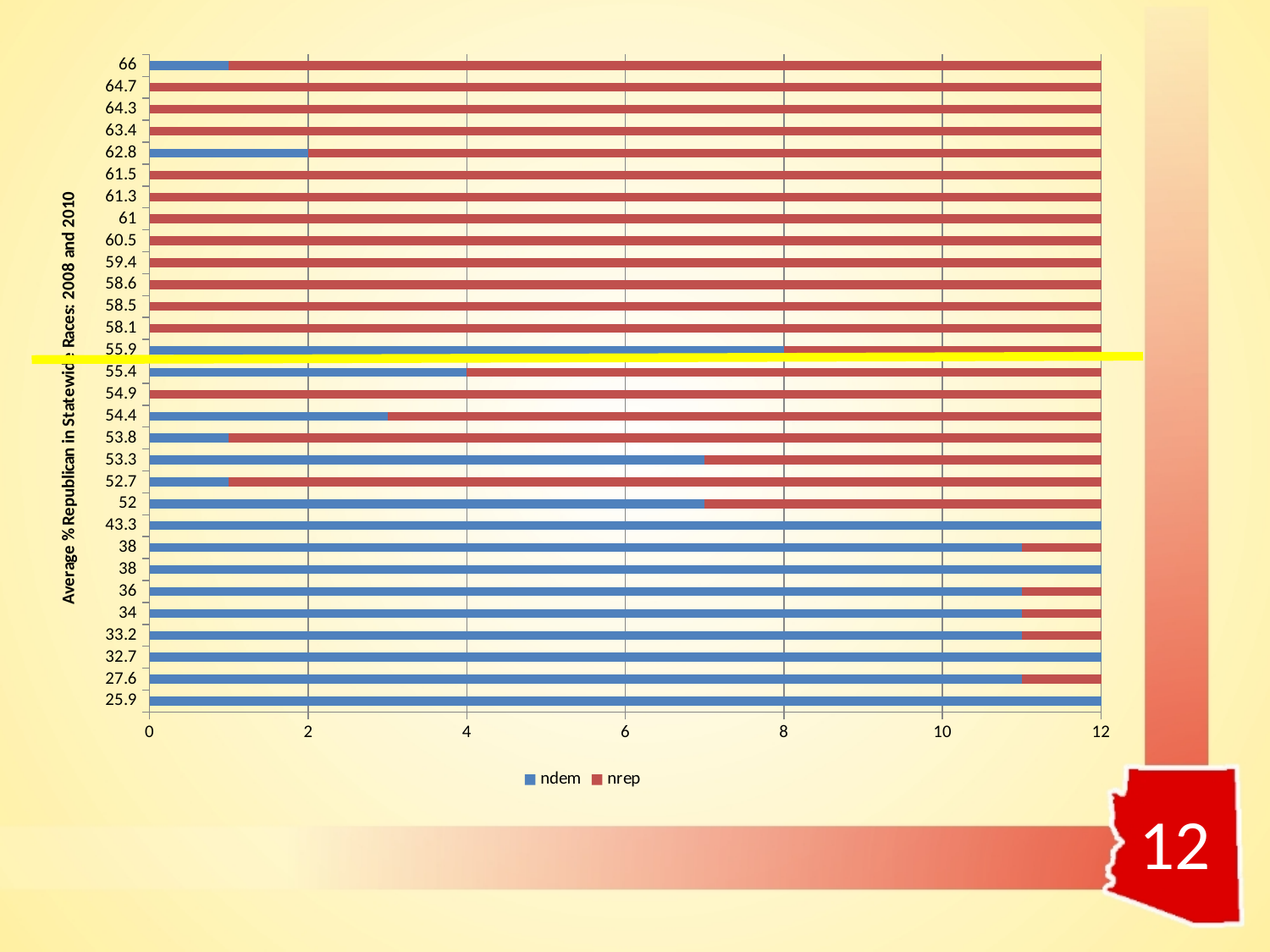
What kind of chart is shown on the slide? bar chart What is the nrep value for the 64.7 category? 12 What are the two series named in the legend? ndem and nrep How many series does the legend list? 2 What is the ndem value for the 62.8 category? 2 What is the ndem value for the 55.9 category? 8 What is the ndem value for the 43.3 category? 12 Which category has the larger ndem value, 55.9 or 54.4? 55.9 Is the nrep value for the 27.6 category greater or less than 2? less How many category bars are plotted on the chart? 30 Is the ndem value for the 53.3 category greater or less than 6? greater What is the ndem value for the 55.4 category? 4